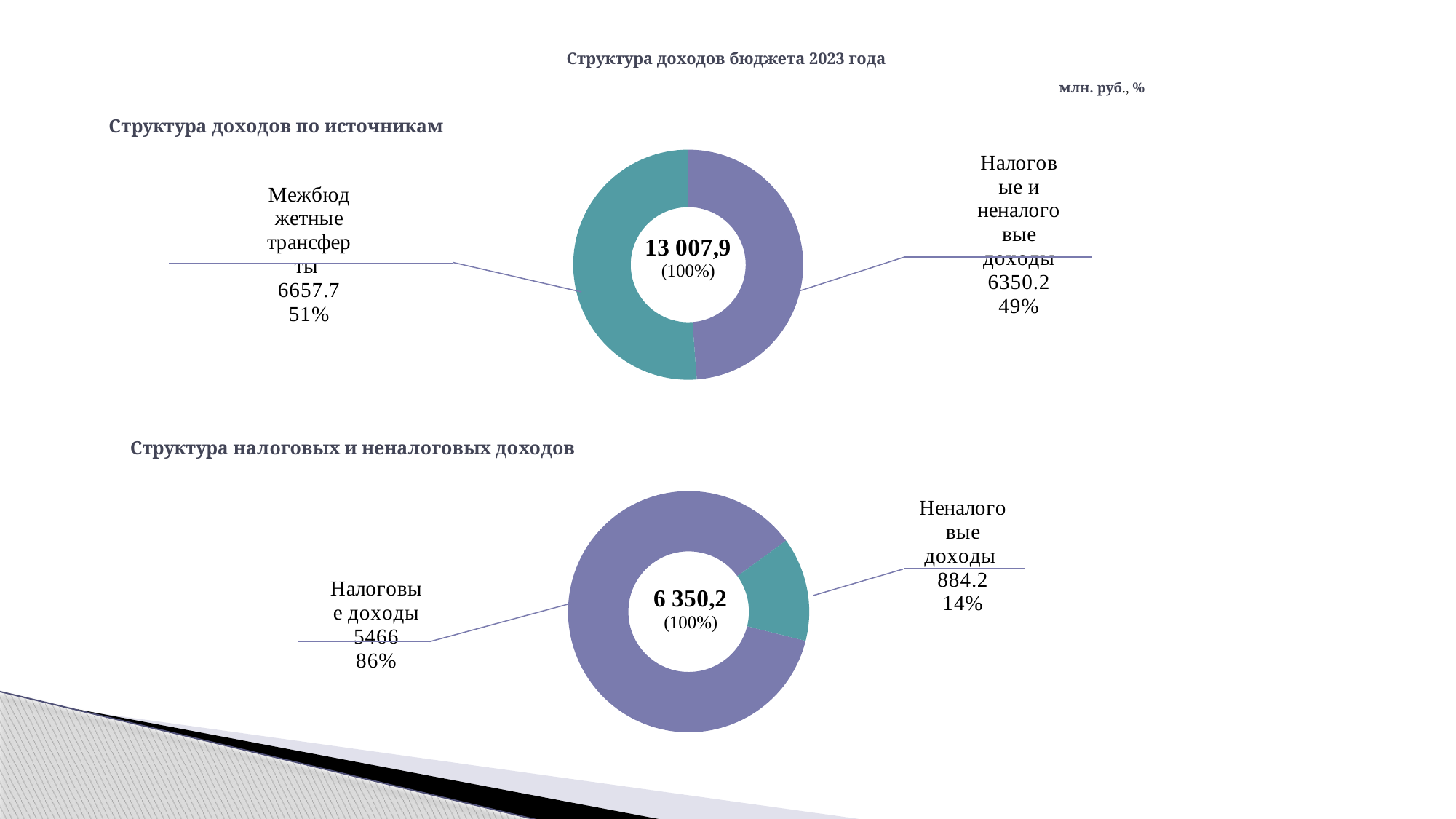
In the top chart 'Структура доходов по источникам', what is the difference between Межбюджетные трансферты and Налоговые и неналоговые доходы? 307.5 In the top chart 'Структура доходов по источникам', what is the value for Межбюджетные трансферты? 6657.7 How many categories does the bottom chart 'Структура налоговых и неналоговых доходов' show? 2 In the top chart 'Структура доходов по источникам', which category is larger: Межбюджетные трансферты or Налоговые и неналоговые доходы? Межбюджетные трансферты In the bottom chart 'Структура налоговых и неналоговых доходов', what is the value for Неналоговые доходы? 884.2 In the top chart 'Структура доходов по источникам', what total is shown in the centre of the donut? 13 007,9 In the bottom chart 'Структура налоговых и неналоговых доходов', what share do Налоговые доходы make up? 86% What type of chart is the top chart 'Структура доходов по источникам'? Donut (pie) chart In the bottom chart 'Структура налоговых и неналоговых доходов', which category is the largest? Налоговые доходы In the top chart 'Структура доходов по источникам', what share do Налоговые и неналоговые доходы make up? 49% What is the overall title of the slide above the two charts? Структура доходов бюджета 2023 года In the bottom chart 'Структура налоговых и неналоговых доходов', what total is shown in the centre of the donut? 6 350,2